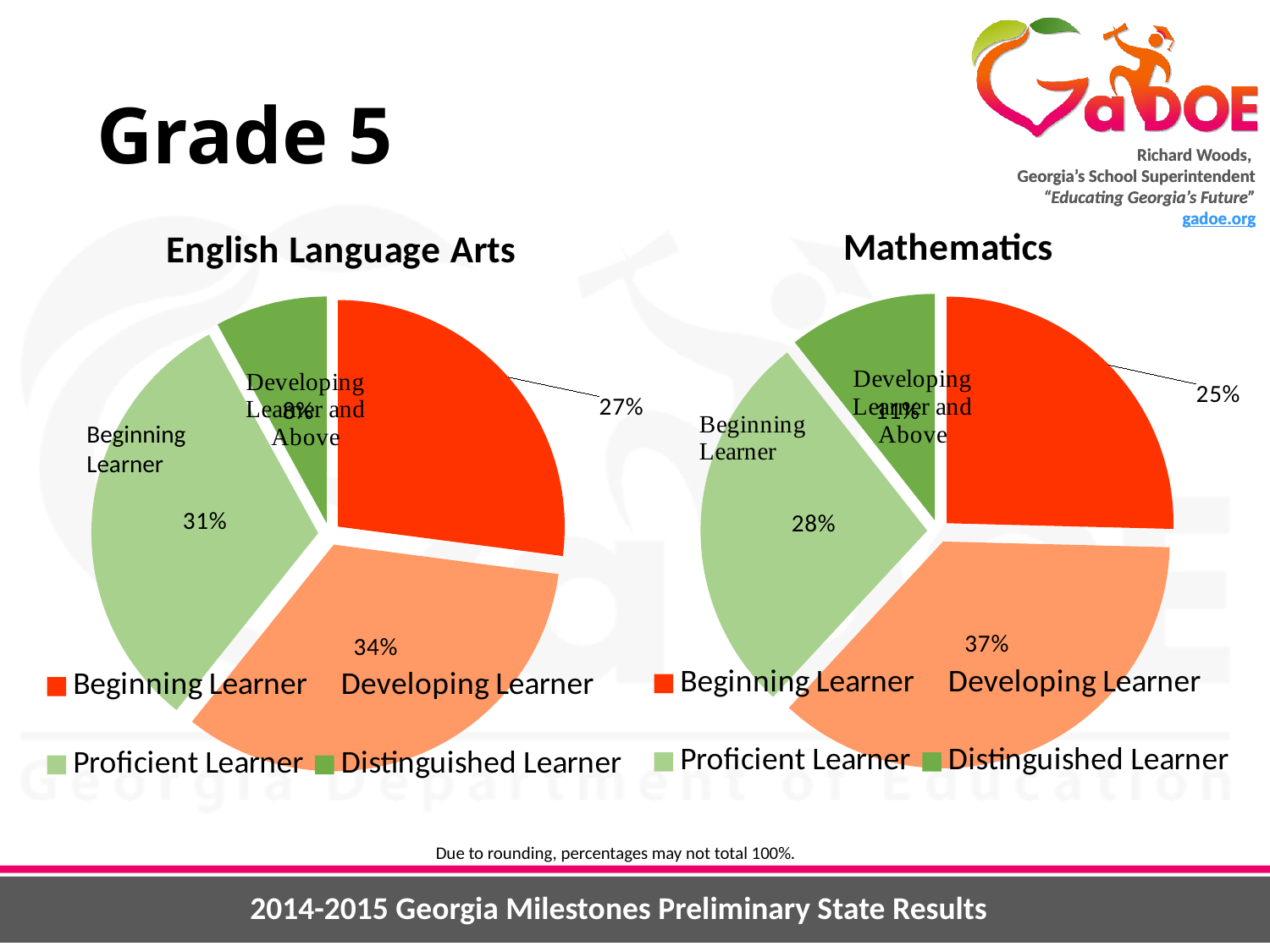
In the Mathematics chart, which learner category has the smallest share? Distinguished Learner In the English Language Arts chart, what percentage of students are Developing Learners? 34% In the Mathematics chart, what percentage of students are Beginning Learners? 25% In the English Language Arts chart, which learner category has the largest share? Developing Learner In the English Language Arts chart, what percentage of students are Beginning Learners? 27% In the Mathematics chart, what percentage of students are Proficient Learners? 28% What type of chart is used for the Mathematics results? Pie chart Which chart shows a larger Developing Learner share, English Language Arts or Mathematics? Mathematics In the English Language Arts chart, what percentage of students are Proficient Learners? 31% How many learner categories does the legend of the English Language Arts chart list? 4 In the Mathematics chart, what percentage of students are Developing Learners? 37% In the English Language Arts chart, how many percentage points larger is the Developing Learner share than the Beginning Learner share? 7 percentage points